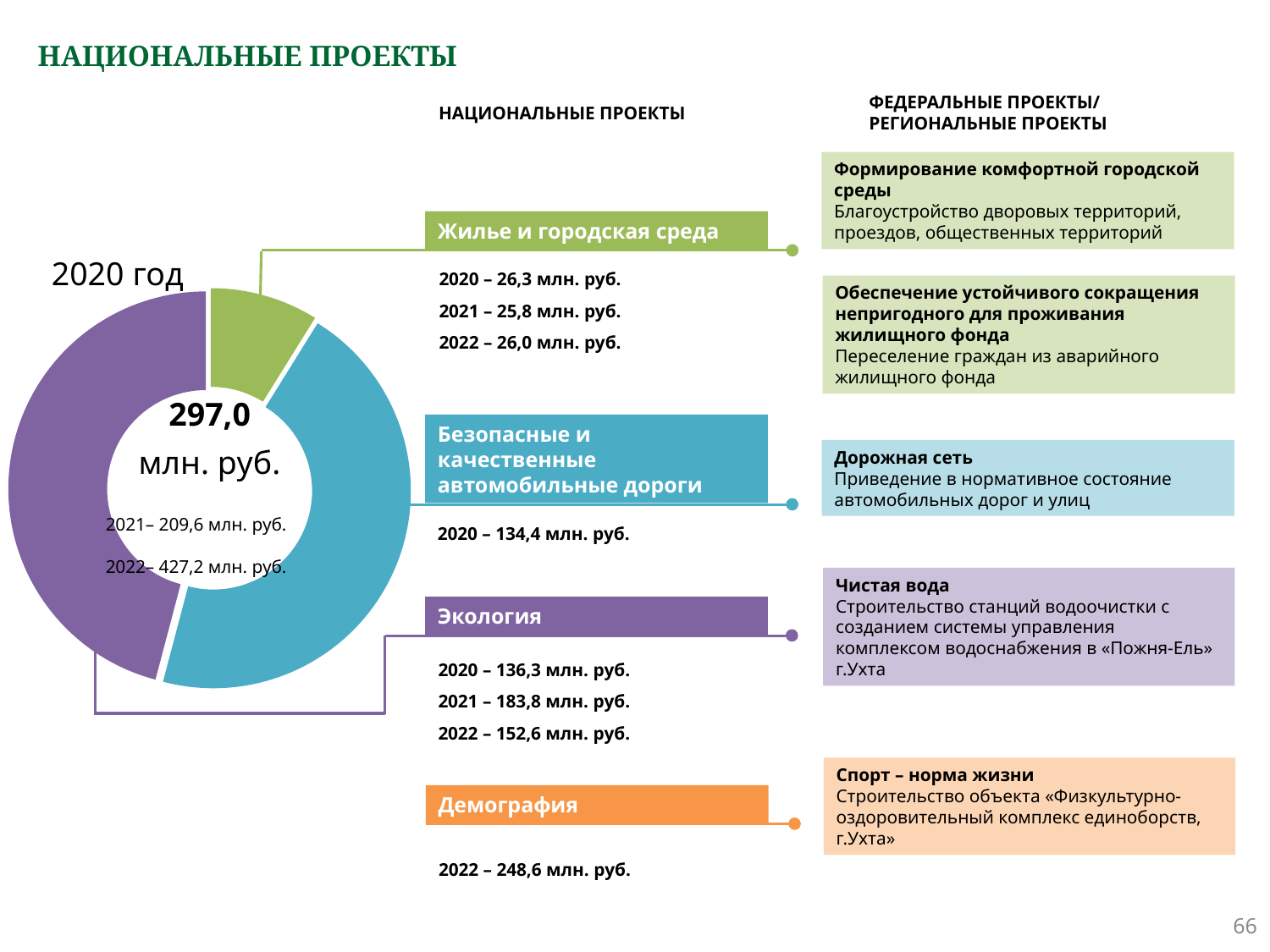
What is the 2020 value for Жилье и городская среда? 26,3 млн. руб. Which national project has the largest slice in the 2020 donut chart? Экология What is the 2020 value for Безопасные и качественные автомобильные дороги? 134,4 млн. руб. What is the 2020 value for Экология? 136,3 млн. руб. What is the difference between the 2020 values for Экология and Безопасные и качественные автомобильные дороги? 1,9 млн. руб. What kind of chart is shown on the slide? Donut (pie) chart How many slices does the donut chart have? 3 Which colour represents Экология in the donut chart? Purple Which is larger in 2020: Экология or Безопасные и качественные автомобильные дороги? Экология Which national project has the smallest slice in the 2020 donut chart? Жилье и городская среда Which year does the donut chart represent? 2020 год What total value is printed in the centre of the donut chart? 297,0 млн. руб.